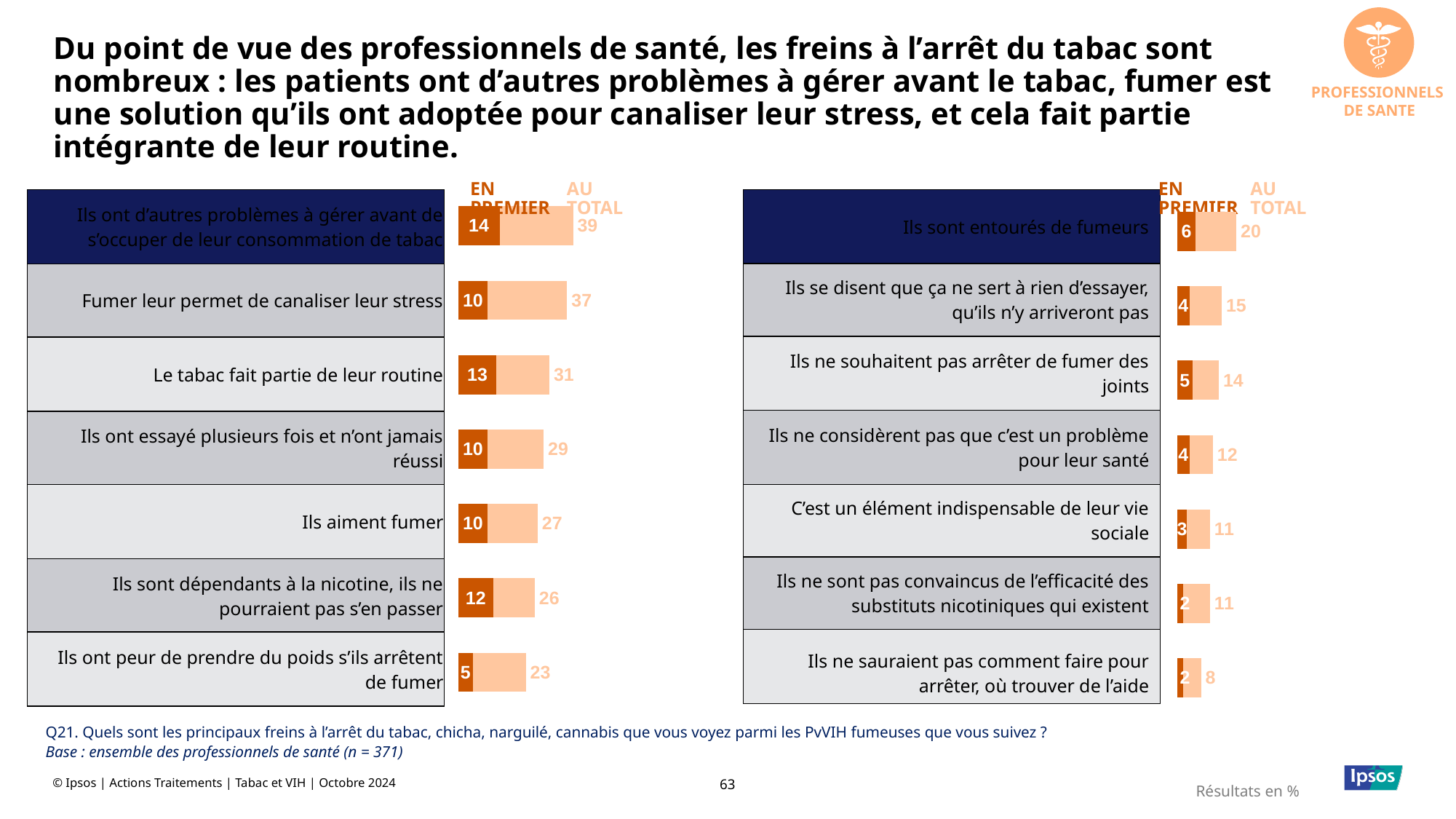
In the right chart, what is the 'AU TOTAL' value for 'Ils sont entourés de fumeurs'? 20 In the left chart, what is the 'EN PREMIER' value for 'Le tabac fait partie de leur routine'? 13 How many series does the left chart show? 2 In the left chart, what is the 'AU TOTAL' value for 'Fumer leur permet de canaliser leur stress'? 37 In the right chart, which has the larger 'AU TOTAL' value: 'Ils sont entourés de fumeurs' or 'Ils ne considèrent pas que c'est un problème pour leur santé'? Ils sont entourés de fumeurs How many categories are shown in the right chart? 7 In the right chart, what is the 'EN PREMIER' value for 'Ils ne souhaitent pas arrêter de fumer des joints'? 5 In the left chart, which category has the highest 'AU TOTAL' value? Ils ont d'autres problèmes à gérer avant de s'occuper de leur consommation de tabac In the left chart, which category has the lowest 'EN PREMIER' value? Ils ont peur de prendre du poids s'ils arrêtent de fumer In the right chart, which category has the lowest 'AU TOTAL' value? Ils ne sauraient pas comment faire pour arrêter, où trouver de l'aide What type of chart is used on the left side of the slide? Bar chart In the left chart, what is the difference between the 'AU TOTAL' values for 'Ils ont d'autres problèmes à gérer avant de s'occuper de leur consommation de tabac' and 'Ils ont peur de prendre du poids s'ils arrêtent de fumer'? 16